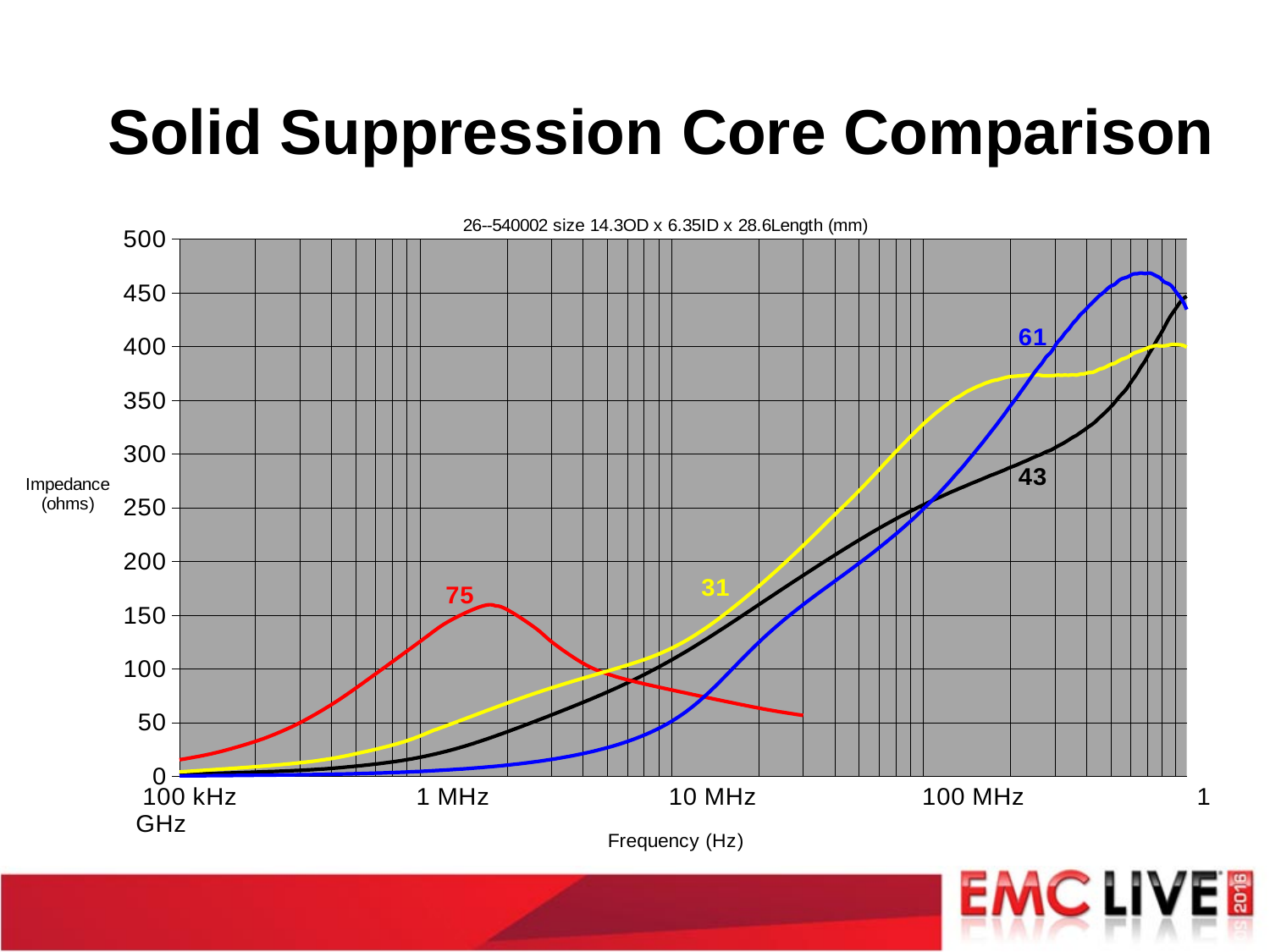
At 100 MHz, which curve has the higher impedance, the 31 material or the 61 material? 31 How many material curves are plotted on the chart? 4 Is the peak impedance of the 61 material curve greater or less than 400 ohms? greater Which material curve has the lowest peak impedance on the chart? 75 At 1 MHz, which curve has the higher impedance, the 75 material or the 31 material? 75 Is the peak impedance of the 75 material curve greater or less than 200 ohms? less Does the impedance of the 75 material curve rise continuously across the frequency range, or does it rise and then fall? rises and then falls Is the impedance of the 31 material curve at 100 MHz greater or less than 300 ohms? greater Which material curve reaches the highest impedance on the chart? 61 What is the label on the vertical axis of the chart? Impedance (ohms) What kind of chart is shown on the slide? line chart